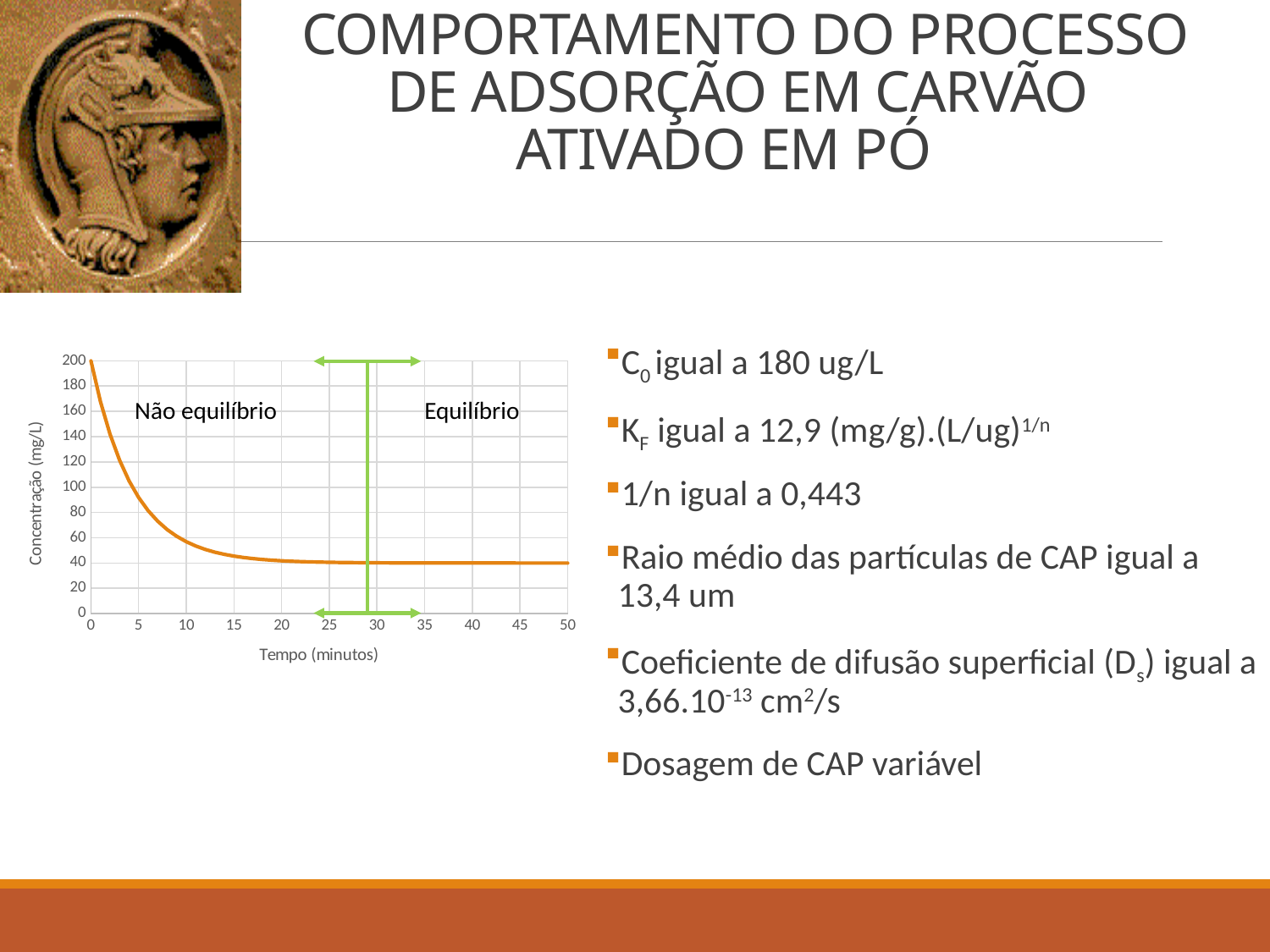
Does the concentration rise or fall as time increases along the x axis? fall What is the highest value shown on the y axis of the chart? 200 What is the label of the x axis of the chart? Tempo (minutos) At what time does the curve reach its highest concentration? 0 minutes Is the concentration at 40 minutes greater or less than 60 mg/L? less Is the concentration at 2 minutes greater or less than 120 mg/L? greater Which is larger, the concentration at 5 minutes or at 30 minutes? 5 minutes Is the concentration at 20 minutes greater or less than 80 mg/L? less What kind of chart is shown on the slide? line chart What is the label of the y axis of the chart? Concentração (mg/L)